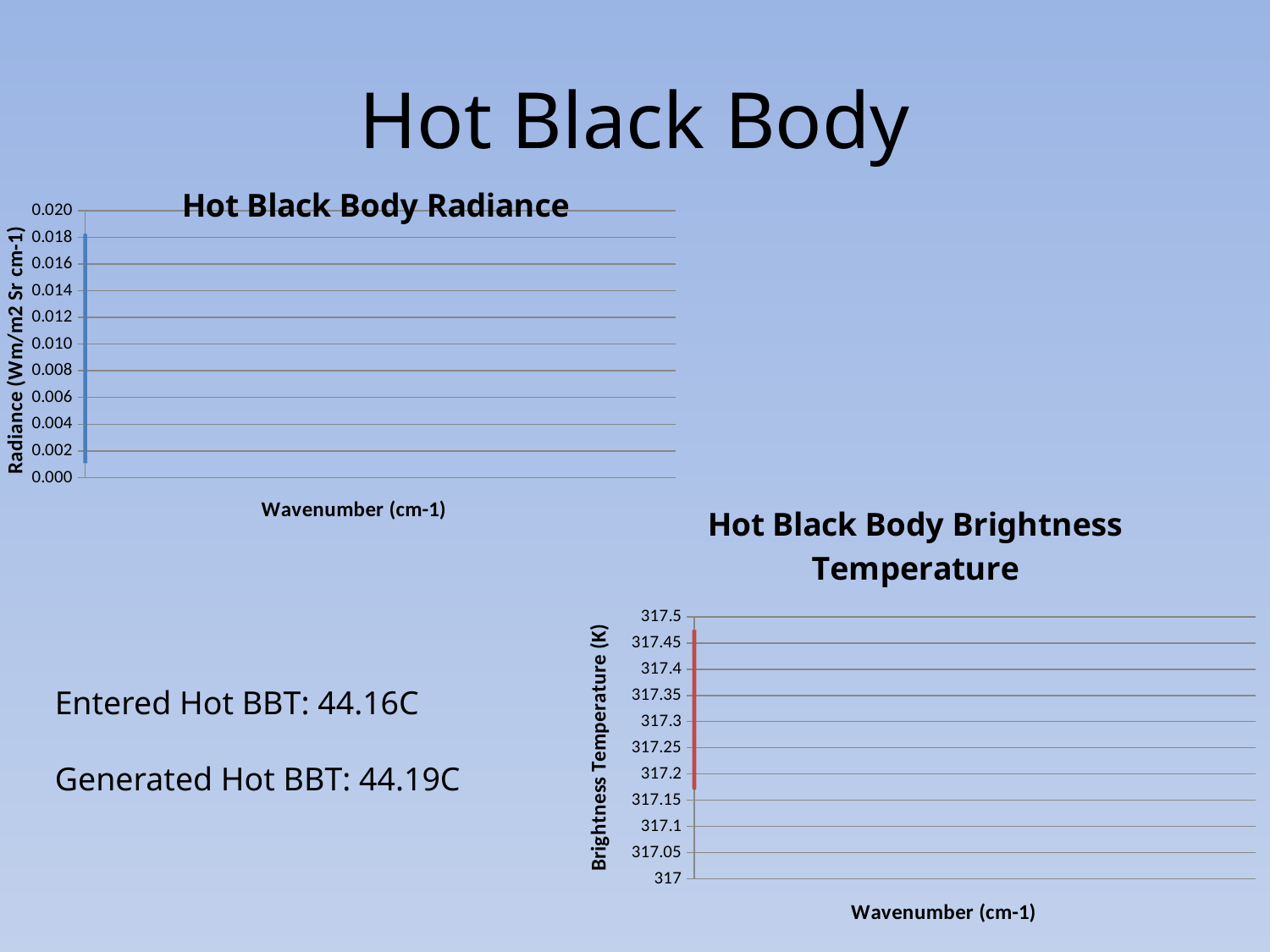
In the Hot Black Body Radiance chart, is the lowest plotted radiance value greater or less than 0.004? less What is the x-axis label of the Hot Black Body Brightness Temperature chart? Wavenumber (cm-1) What kind of chart is the Hot Black Body Radiance chart? line chart What is the y-axis label of the Hot Black Body Brightness Temperature chart? Brightness Temperature (K) What is the y-axis label of the Hot Black Body Radiance chart? Radiance (Wm/m2 Sr cm-1) In the Hot Black Body Brightness Temperature chart, is the lowest plotted brightness temperature greater or less than 317.1? greater In the Hot Black Body Radiance chart, is the highest plotted radiance value greater or less than 0.016? greater What kind of chart is the Hot Black Body Brightness Temperature chart? line chart